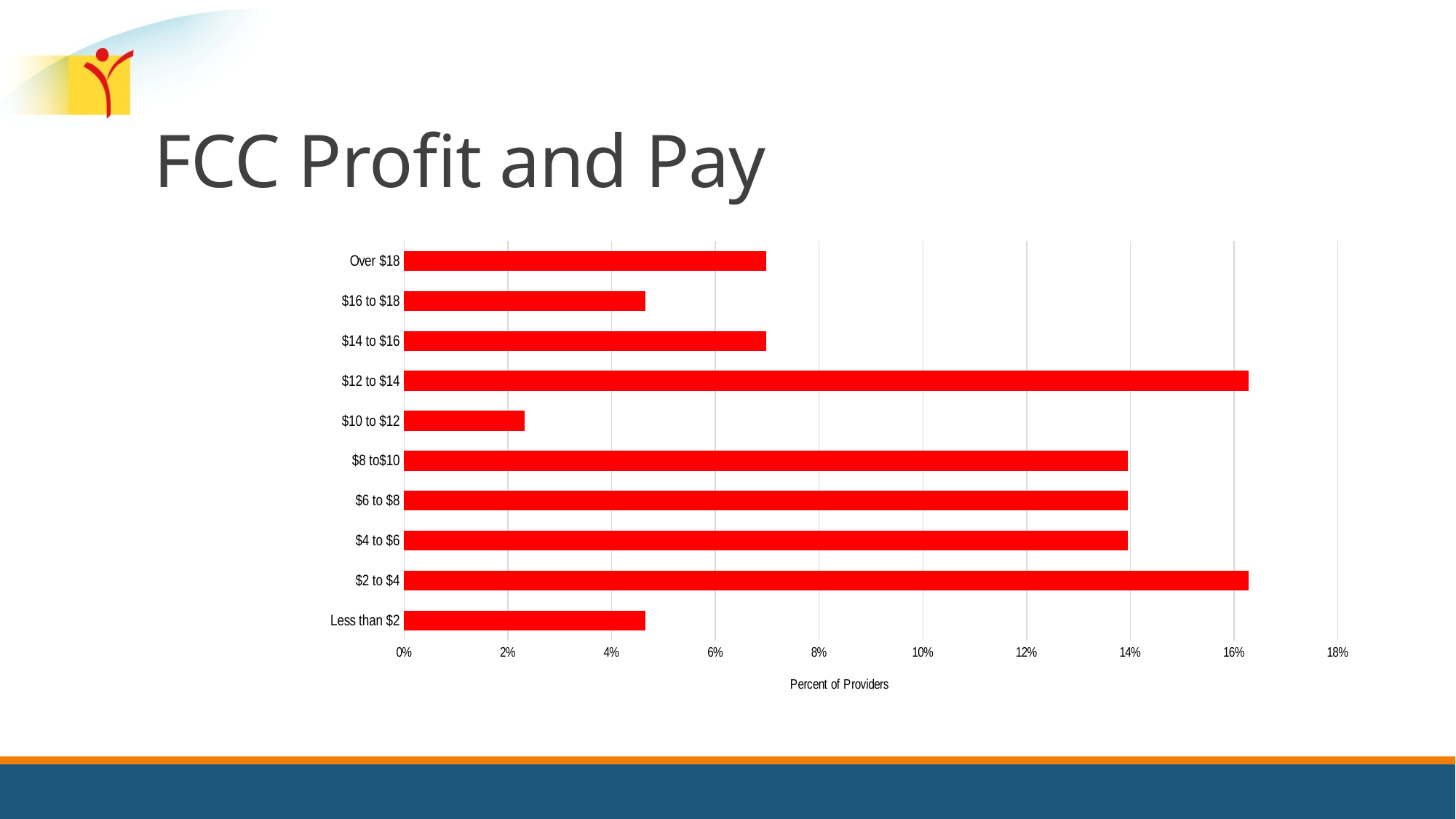
Which category has the lowest percent of providers? $10 to $12 Is the value for Less than $2 greater or less than 6%? less Is the value for $12 to $14 greater or less than 16%? greater What is the title of the slide containing the chart? FCC Profit and Pay What is the label on the horizontal axis of the chart? Percent of Providers Which is larger, the value for $10 to $12 or the value for $8 to$10? $8 to$10 How many categories are plotted in the chart? 10 Is the value for Over $18 greater or less than 6%? greater What kind of chart is shown on the slide? bar chart Which is larger, the value for $2 to $4 or the value for $16 to $18? $2 to $4